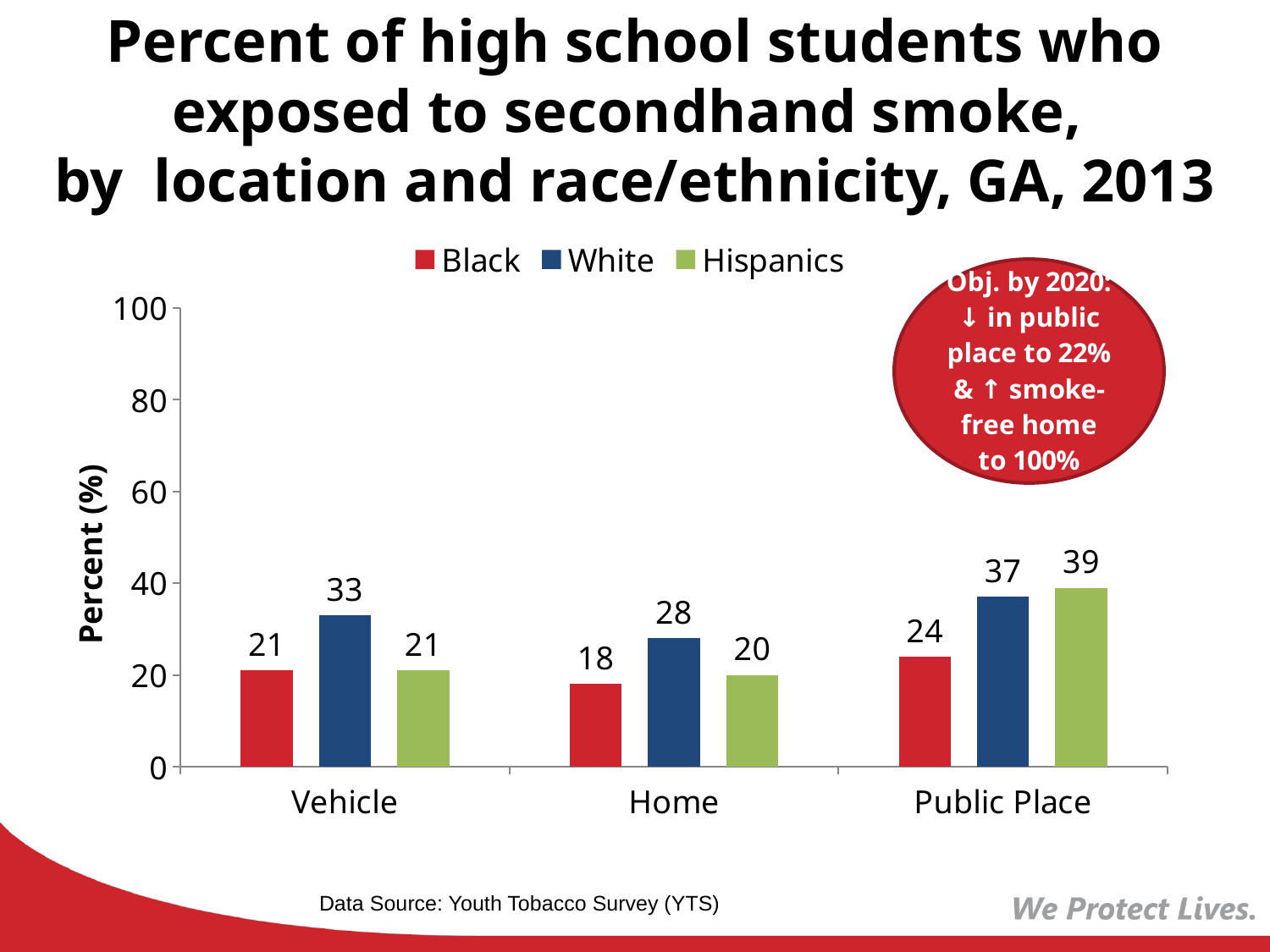
What is the value for Hispanics in the Home category? 20 How many location categories are shown on the x axis? 3 Which series has the highest value in the Public Place category? Hispanics Which is larger: the Hispanics value for Public Place or the White value for Public Place? Hispanics value for Public Place What is the value for Black students in the Public Place category? 24 Which series has the lowest value in the Home category? Black What is the value for White students in the Vehicle category? 33 What is the label of the y axis? Percent (%) What kind of chart is shown on the slide? bar chart Is the value for White students in the Public Place category greater or less than 40? less How many series does the legend list? 3 What is the difference between the White and Black values in the Home category? 10